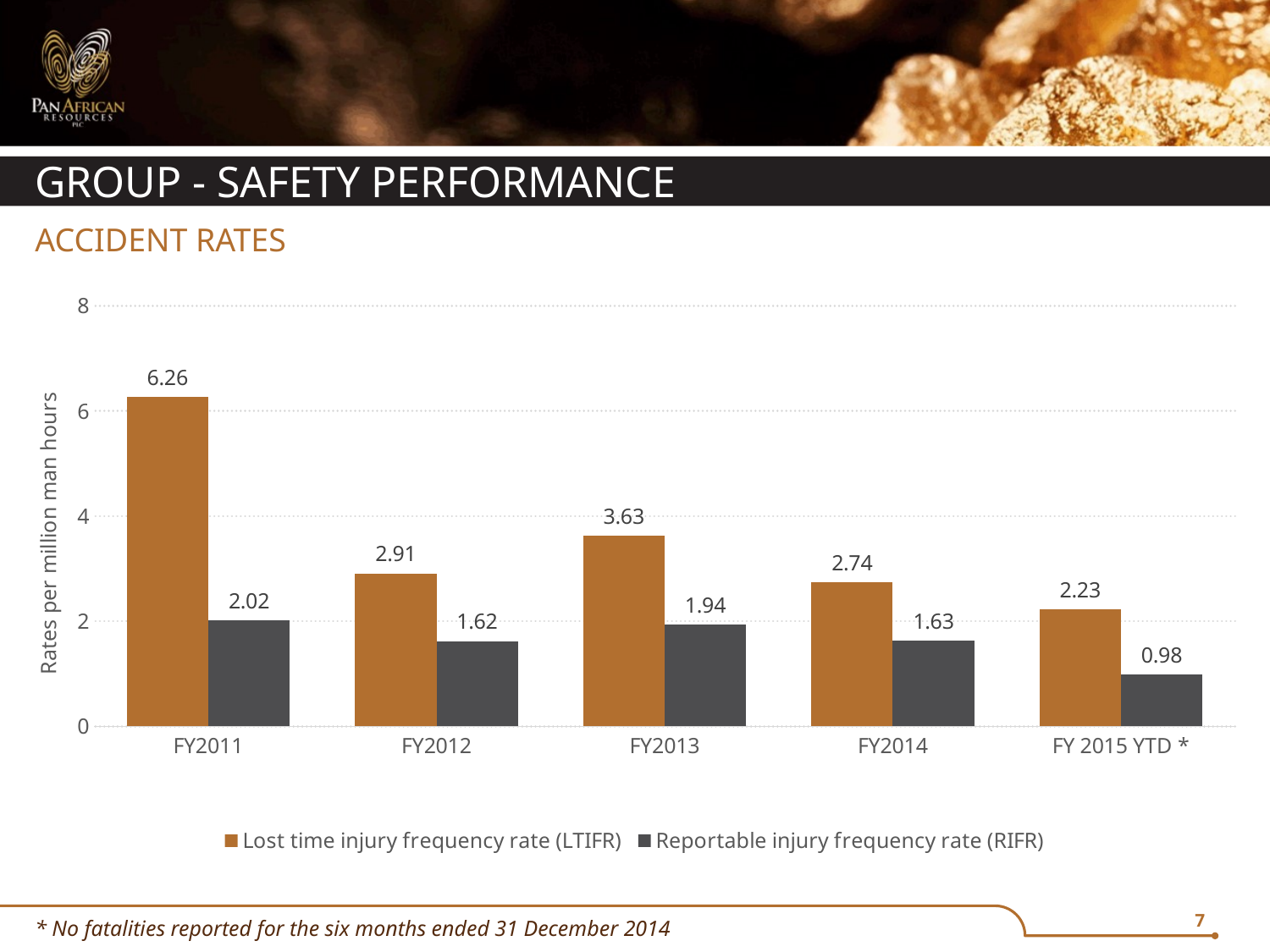
Which fiscal year has the highest LTIFR? FY2011 Which fiscal year has the lowest RIFR? FY 2015 YTD * What kind of chart is shown on the slide? bar chart How many series does the legend list? 2 What is the Lost time injury frequency rate (LTIFR) for FY2011? 6.26 What is the Reportable injury frequency rate (RIFR) for FY 2015 YTD *? 0.98 What is the LTIFR value for FY2013? 3.63 Is the LTIFR for FY2014 greater or less than 2? greater How many fiscal year categories are shown on the x axis? 5 What is the label of the vertical axis? Rates per million man hours Which is larger, the RIFR for FY2013 or the RIFR for FY2014? FY2013 What is the difference between the LTIFR and RIFR in FY2012? 1.29